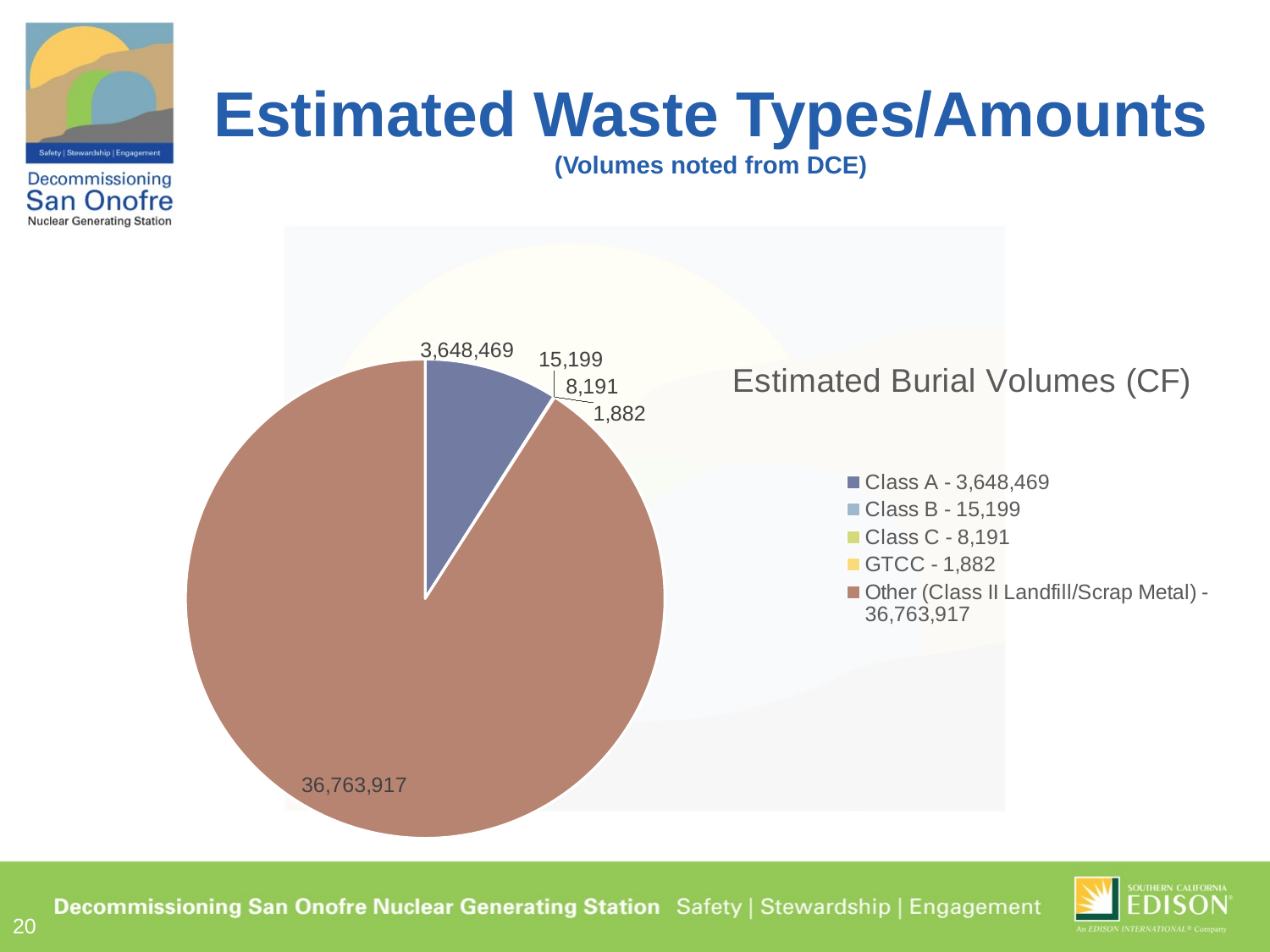
Which is larger, the burial volume for Class A or for Class B? Class A What is the estimated burial volume for Class B? 15,199 What is the difference between the Class C and GTCC burial volumes? 6,309 What is the estimated burial volume for Class C? 8,191 What is the estimated burial volume for GTCC? 1,882 How many categories does the pie chart show? 5 Which category has the smallest estimated burial volume? GTCC What type of chart is shown on the slide? Pie chart What is the difference between the Class B and Class C burial volumes? 7,008 Which category has the largest estimated burial volume? Other (Class II Landfill/Scrap Metal) What is the estimated burial volume for Class A? 3,648,469 What is the estimated burial volume for Other (Class II Landfill/Scrap Metal)? 36,763,917